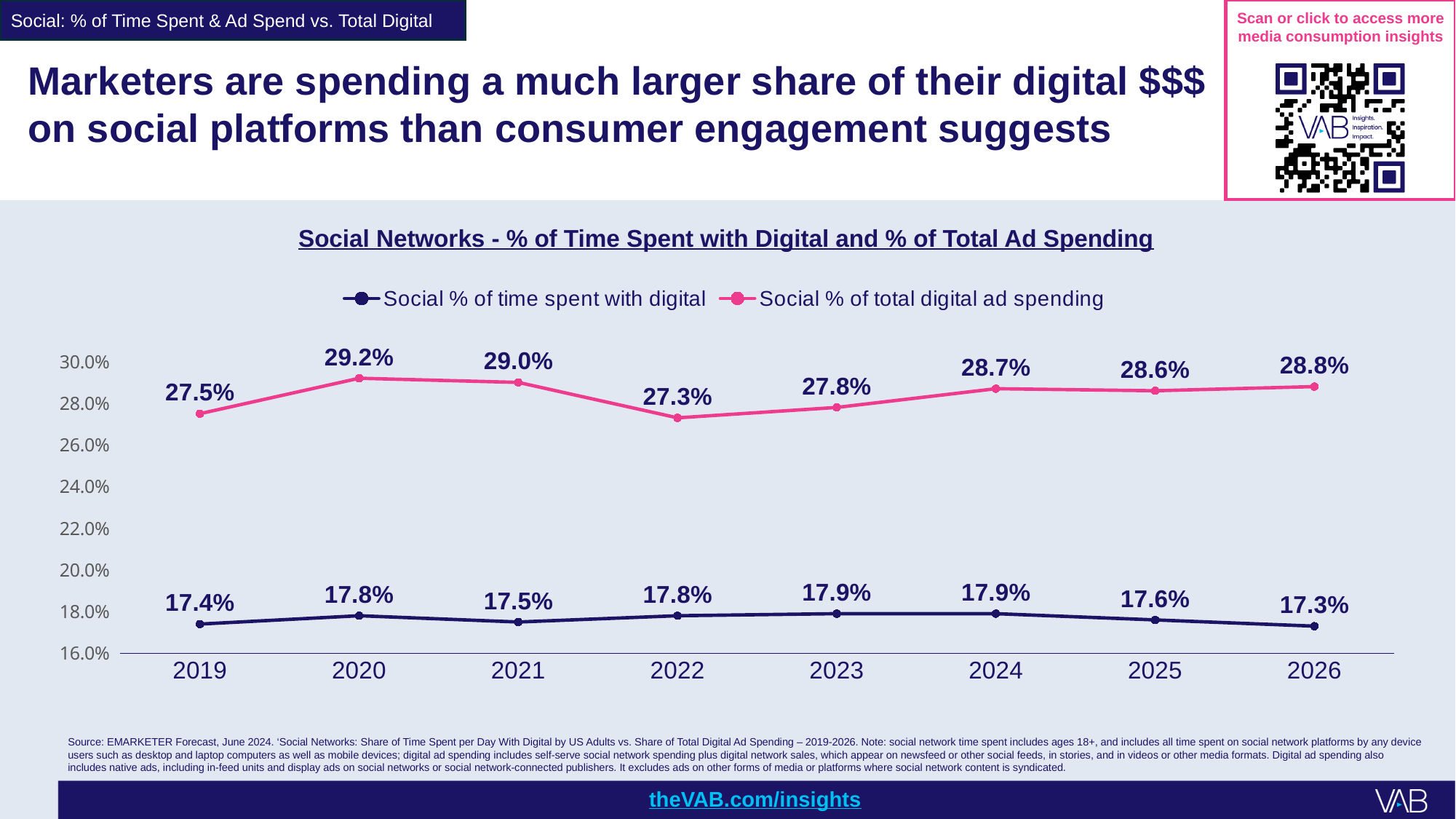
What is the Social % of total digital ad spending in 2020? 29.2% What is the Social % of time spent with digital in 2023? 17.9% In which year is the Social % of total digital ad spending highest? 2020 What kind of chart is shown on the slide? Line chart What is the title of the chart? Social Networks - % of Time Spent with Digital and % of Total Ad Spending How many series does the legend list? 2 What is the difference between Social % of total digital ad spending and Social % of time spent with digital in 2019? 10.1% Is the Social % of total digital ad spending in 2021 greater or less than 26.0%? greater What is the Social % of total digital ad spending in 2026? 28.8% In which year is the Social % of time spent with digital lowest? 2026 How many years are shown on the x axis? 8 Which is larger in 2022: Social % of total digital ad spending or Social % of time spent with digital? Social % of total digital ad spending